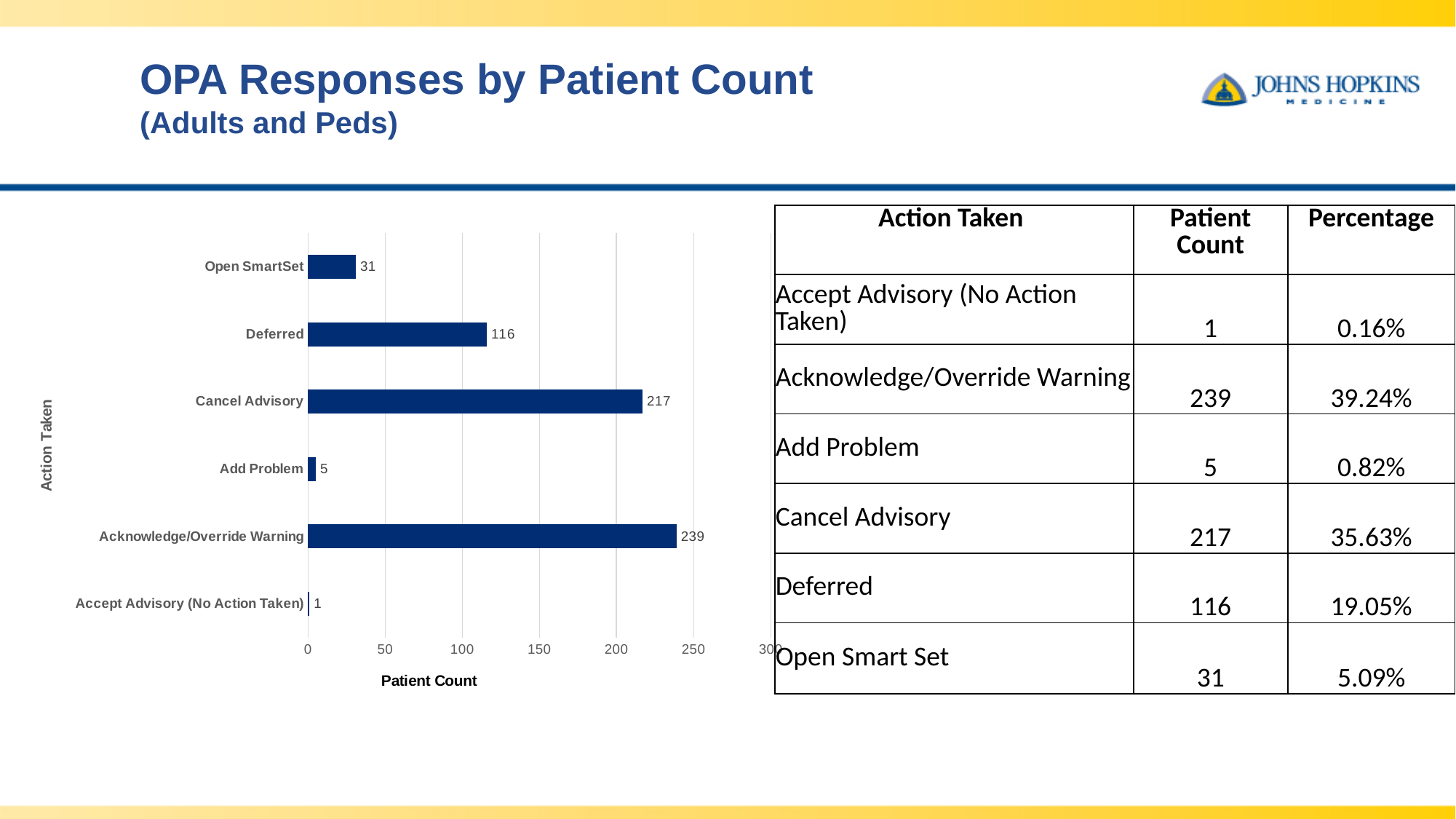
What is the difference in patient count between Acknowledge/Override Warning and Cancel Advisory? 22 What is the patient count for Cancel Advisory in the bar chart? 217 What is the patient count for Deferred in the bar chart? 116 Which action taken has the lowest patient count in the bar chart? Accept Advisory (No Action Taken) Which action taken has the highest patient count in the bar chart? Acknowledge/Override Warning What kind of chart is used to show OPA responses by patient count? bar chart What is the difference in patient count between Deferred and Open SmartSet? 85 Which has a larger patient count, Deferred or Add Problem? Deferred What is the label of the horizontal axis of the bar chart? Patient Count How many action categories are shown in the bar chart? 6 Is the patient count for Cancel Advisory greater or less than 200? greater What is the patient count for Open SmartSet in the bar chart? 31